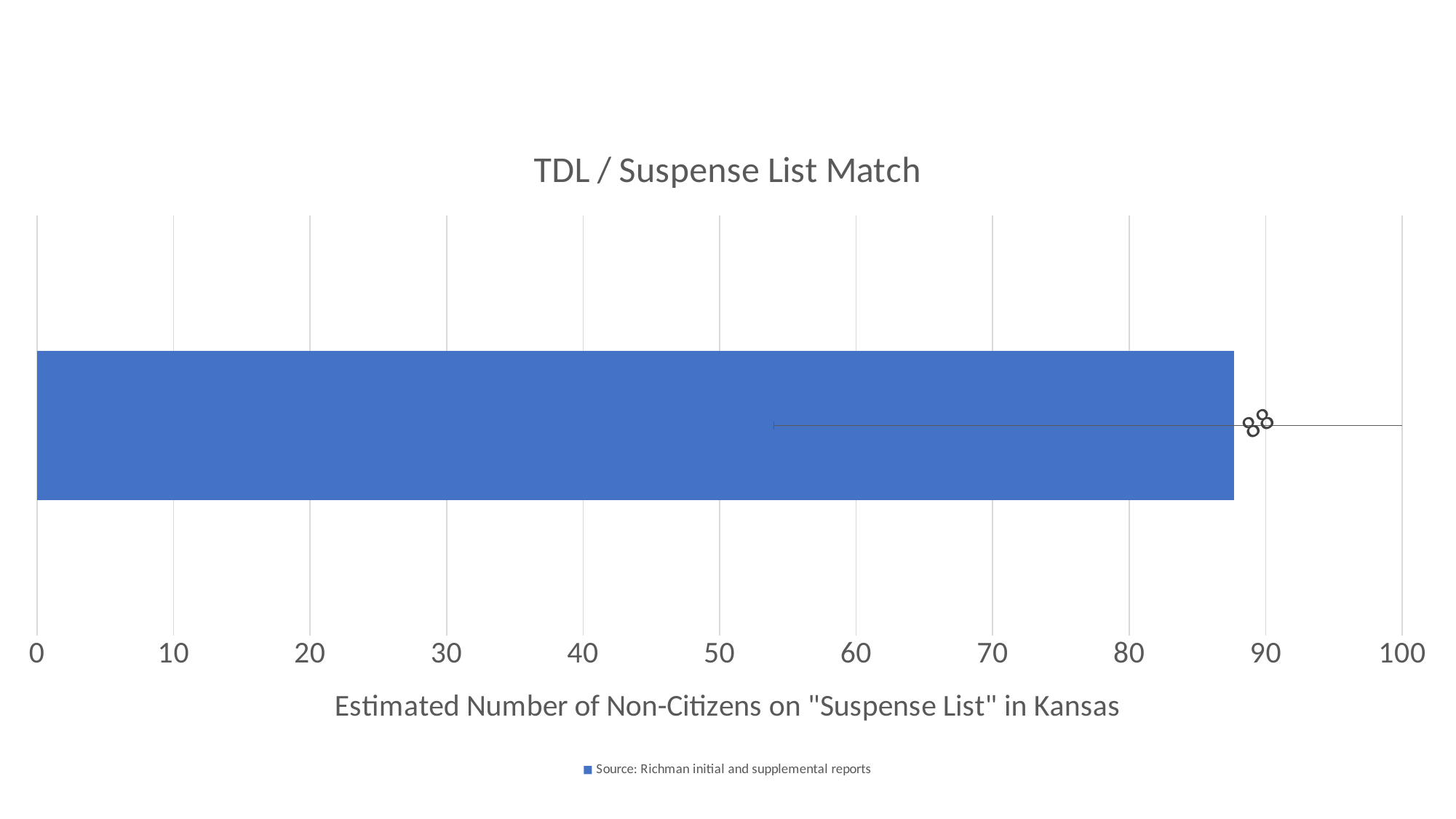
What is the legend entry shown below the chart? Source: Richman initial and supplemental reports How many series does the legend list? 1 What is the value shown by the data label on the bar in the chart? 88 What is the highest tick value shown on the horizontal axis? 100 Is the value of the bar greater or less than 90? less Is the value of the bar greater or less than 80? greater What is the title of the chart? TDL / Suspense List Match What kind of chart is shown on the slide? bar chart How many bars are plotted in the chart? 1